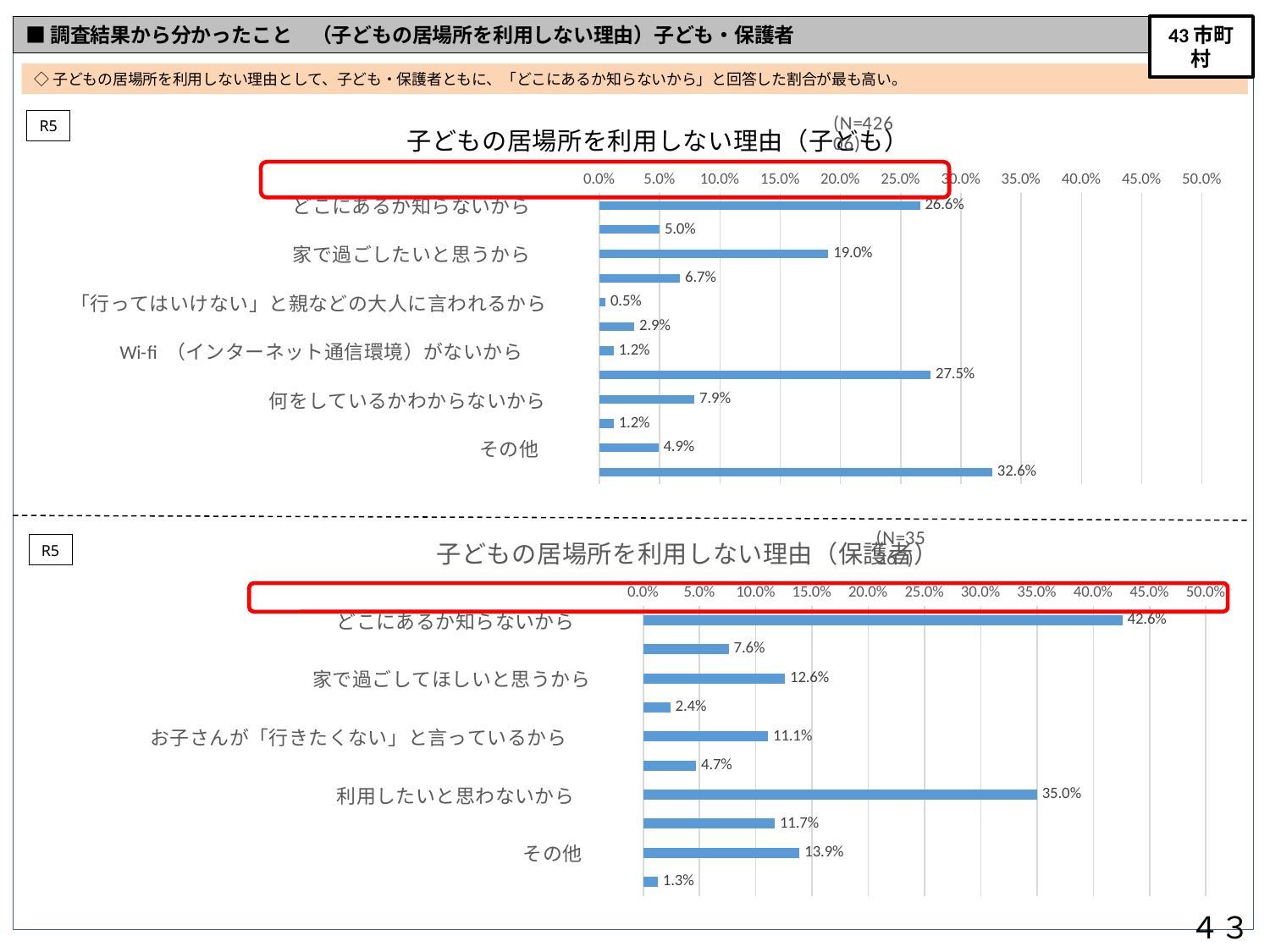
What is the sample size (N) shown for the top chart (子ども)? N=426 What type of chart is the top chart, 子どもの居場所を利用しない理由（子ども）? bar chart In the bottom chart (保護者), how many bars are plotted? 10 In the bottom chart (保護者), what is the value for どこにあるか知らないから? 42.6% In the bottom chart (保護者), what is the value for 利用したいと思わないから? 35.0% In the top chart (子ども), what is the value for 「行ってはいけない」と親などの大人に言われるから? 0.5% In the top chart (子ども), what is the difference between どこにあるか知らないから and 家で過ごしたいと思うから? 7.6 percentage points In the top chart (子ども), which is larger: 何をしているかわからないから or その他? 何をしているかわからないから In the top chart (子ども), what is the value for 家で過ごしたいと思うから? 19.0% In the top chart (子ども), what is the value for どこにあるか知らないから? 26.6% In the bottom chart (保護者), which labeled category has the highest value? どこにあるか知らないから In the top chart (子ども), what is the highest value shown on any bar? 32.6%